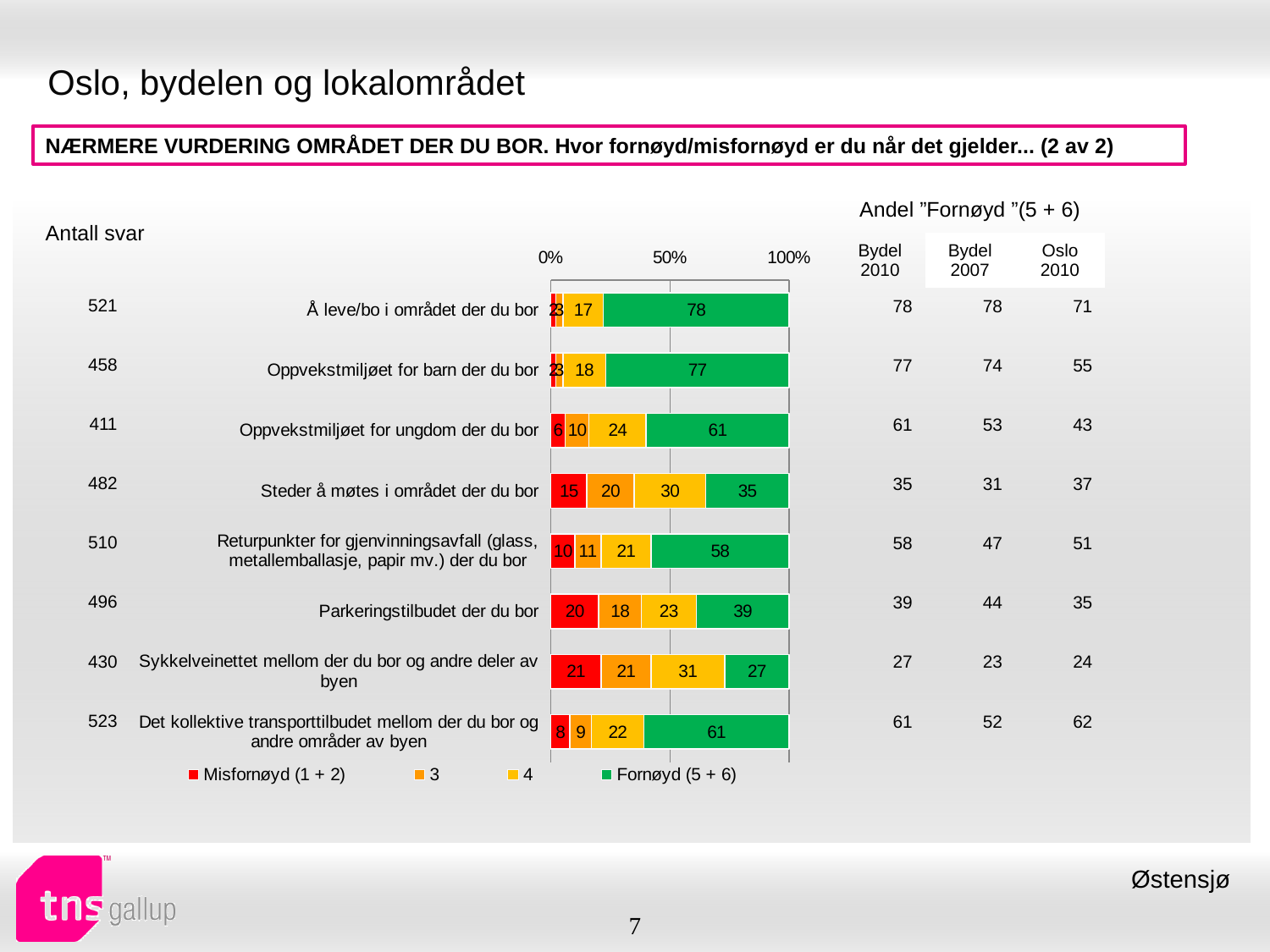
Which category has the highest Fornøyd (5 + 6) value? Å leve/bo i området der du bor Which category has the lowest Fornøyd (5 + 6) value? Sykkelveinettet mellom der du bor og andre deler av byen What is the value of the Fornøyd (5 + 6) segment for "Parkeringstilbudet der du bor"? 39 What is the difference between the Fornøyd (5 + 6) values for "Parkeringstilbudet der du bor" and "Steder å møtes i området der du bor"? 4 Which has the larger Misfornøyd (1 + 2) value: "Parkeringstilbudet der du bor" or "Steder å møtes i området der du bor"? Parkeringstilbudet der du bor How many series does the legend list? 4 What kind of chart is shown on the slide? Stacked bar chart Which legend entry is shown in green? Fornøyd (5 + 6) What is the total of the stacked bar for "Sykkelveinettet mellom der du bor og andre deler av byen"? 100 How many categories are shown in the bar chart? 8 What is the Misfornøyd (1 + 2) value for "Det kollektive transporttilbudet mellom der du bor og andre områder av byen"? 8 What is the value of the "4" segment for "Oppvekstmiljøet for ungdom der du bor"? 24